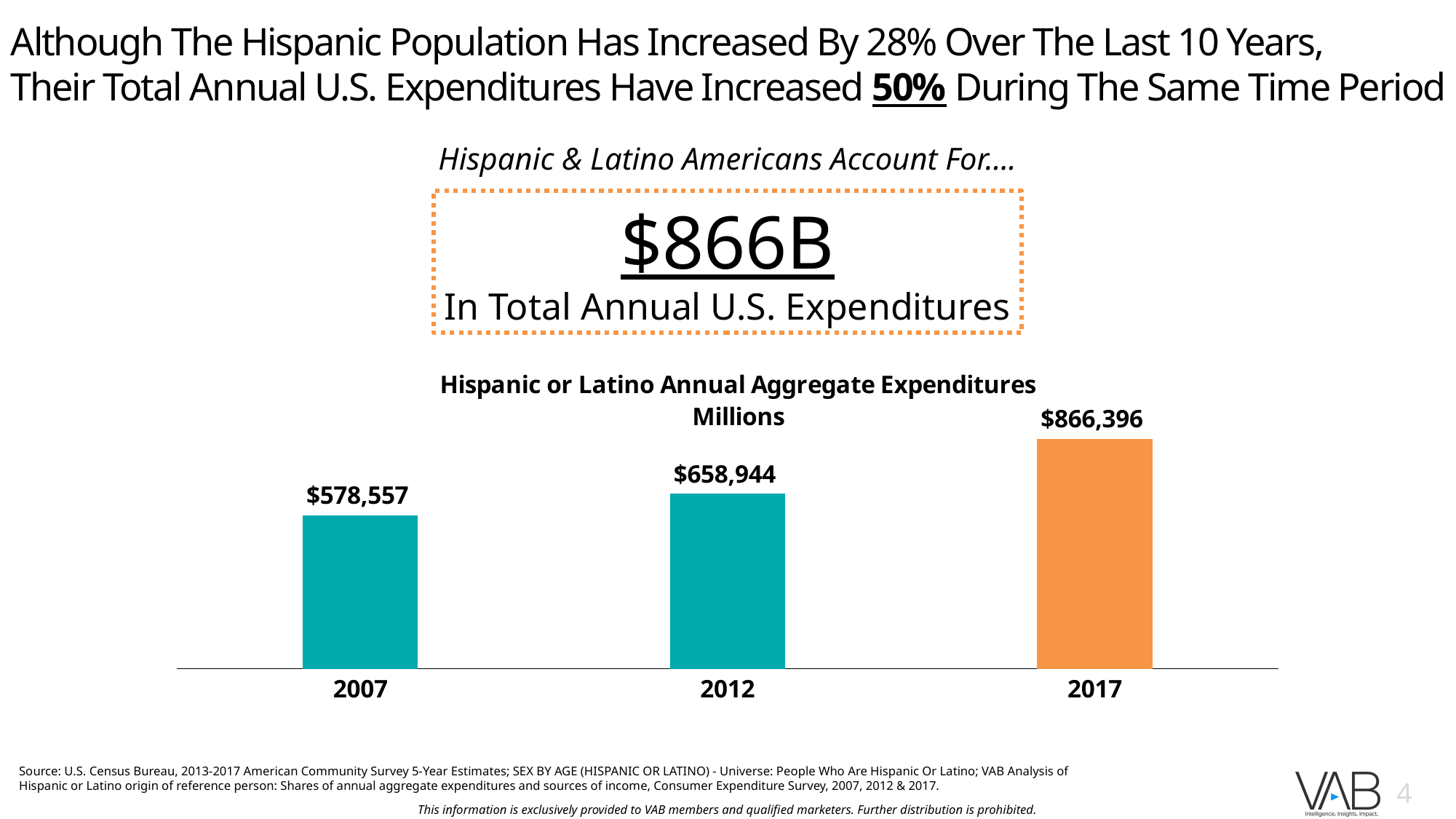
What is the difference between the 2012 and 2007 values? $80,387 How many years are shown on the chart? 3 Which is larger, the value for 2012 or the value for 2017? 2017 Which year has the highest value? 2017 What is the value for 2007? $578,557 What is the difference between the 2017 and 2007 values? $287,839 What is the value for 2012? $658,944 What is the difference between the 2017 and 2012 values? $207,452 Which year has the lowest value? 2007 What kind of chart is shown on the slide? Bar chart What is the value for 2017? $866,396 Do the values rise or fall from 2007 to 2017? Rise